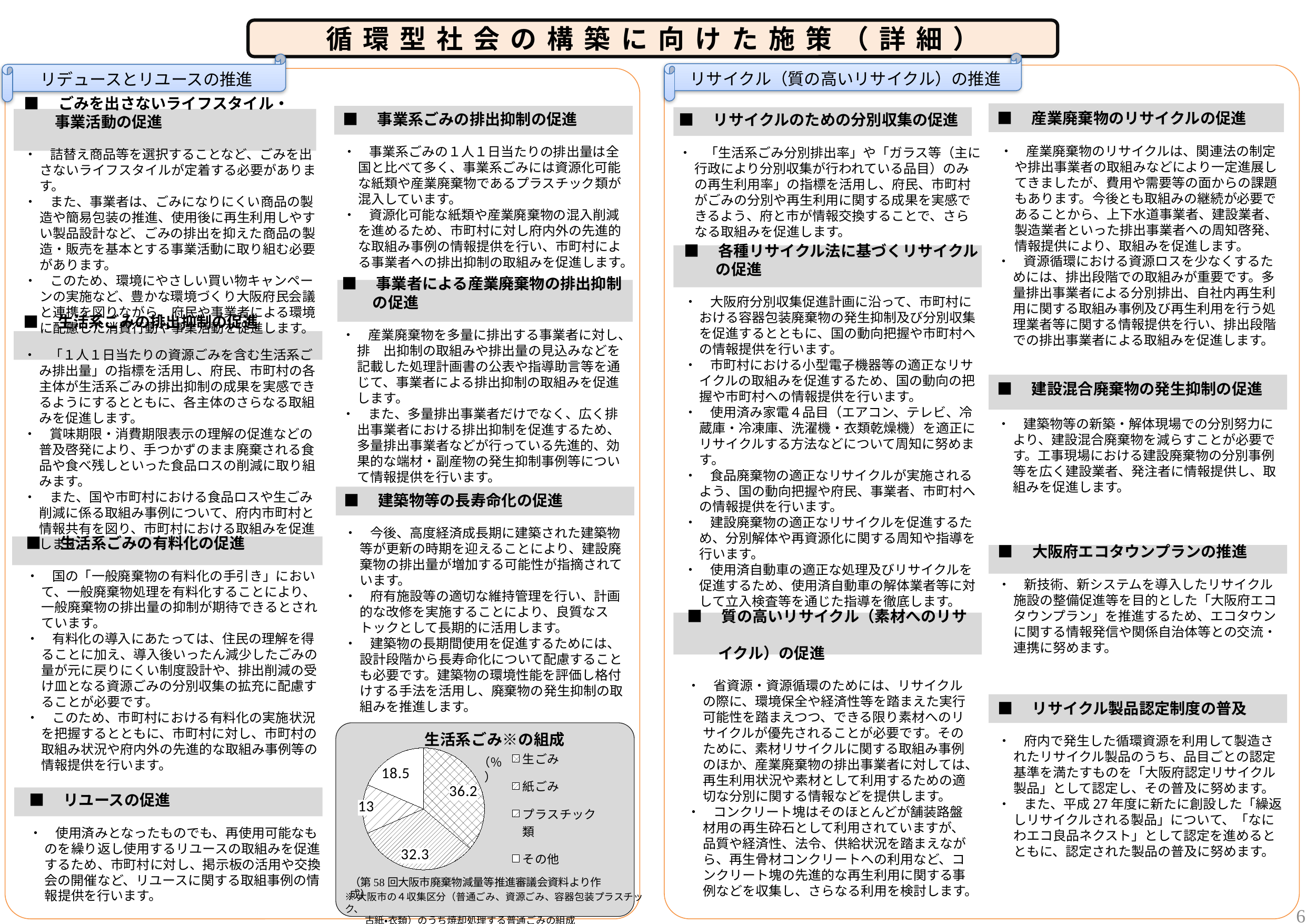
What is the title of the chart on the slide? 生活系ごみ※の組成 What is the value for 紙ごみ in the pie chart? 32.3 What is the value for その他 in the pie chart? 18.5 How many slices does the pie chart have? 4 What is the value for 生ごみ in the pie chart? 36.2 Which category has the largest slice in the pie chart? 生ごみ How many entries does the legend of the pie chart list? 4 What is the value for プラスチック類 in the pie chart? 13 What is the difference between the values for 生ごみ and 紙ごみ in the pie chart? 3.9 Which category has the smallest slice in the pie chart? プラスチック類 What kind of chart is shown on the slide? pie chart Which is larger in the pie chart, その他 or プラスチック類? その他